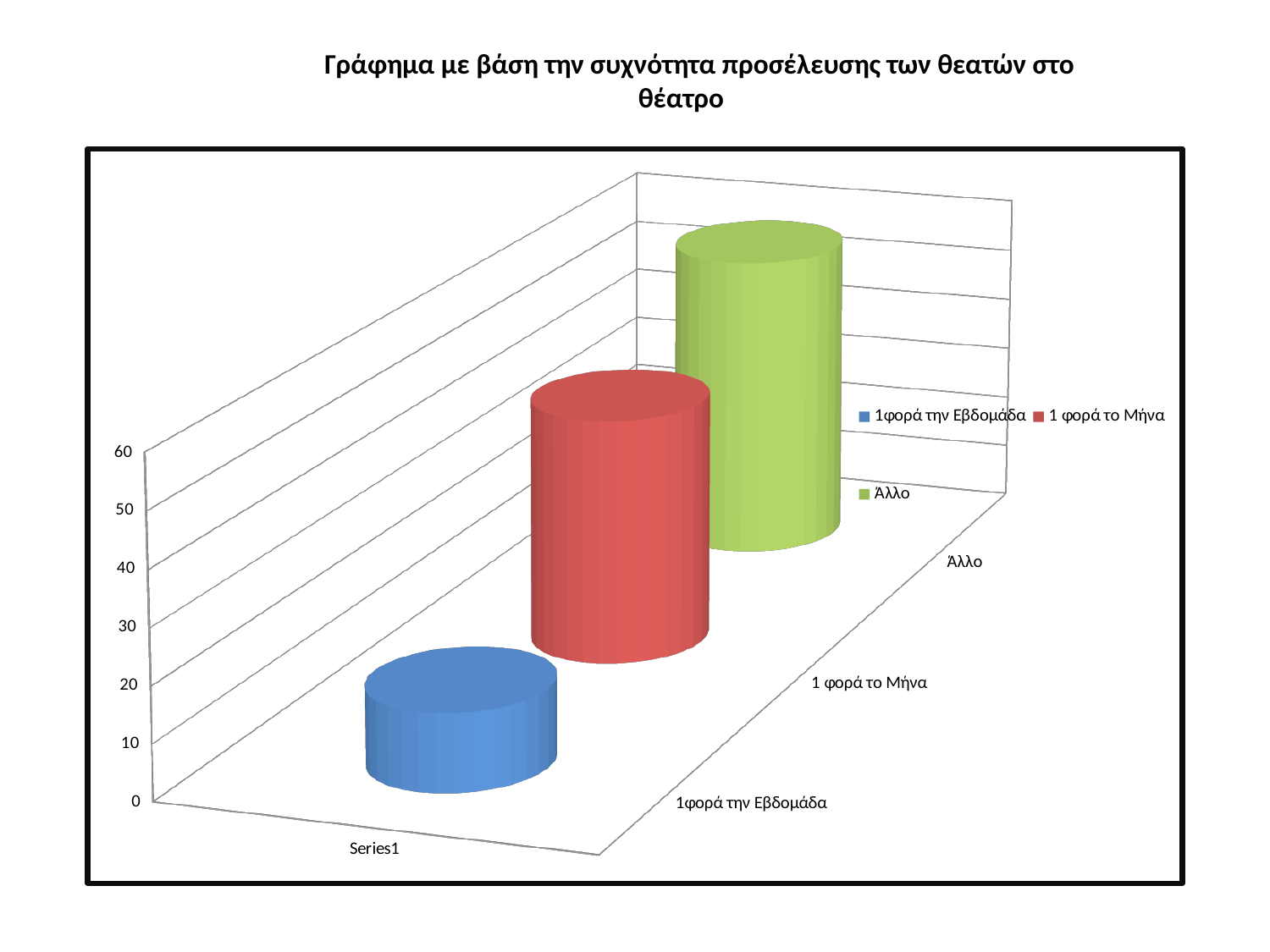
How many entries does the chart legend list? 3 What kind of chart is shown on the slide? bar chart Is the value for Άλλο greater or less than 40? greater Which is larger, the value for 1 φορά το Μήνα or the value for 1φορά την Εβδομάδα? 1 φορά το Μήνα Is the value for 1φορά την Εβδομάδα greater or less than 30? less Is the value for 1 φορά το Μήνα greater or less than 30? greater Which is larger, the value for Άλλο or the value for 1 φορά το Μήνα? Άλλο How many categories are plotted in the chart? 3 What colour is the bar for Άλλο? green Do the values rise or fall moving from 1φορά την Εβδομάδα to Άλλο along the category axis? rise Which category has the highest value in the chart? Άλλο Which category has the lowest value in the chart? 1φορά την Εβδομάδα